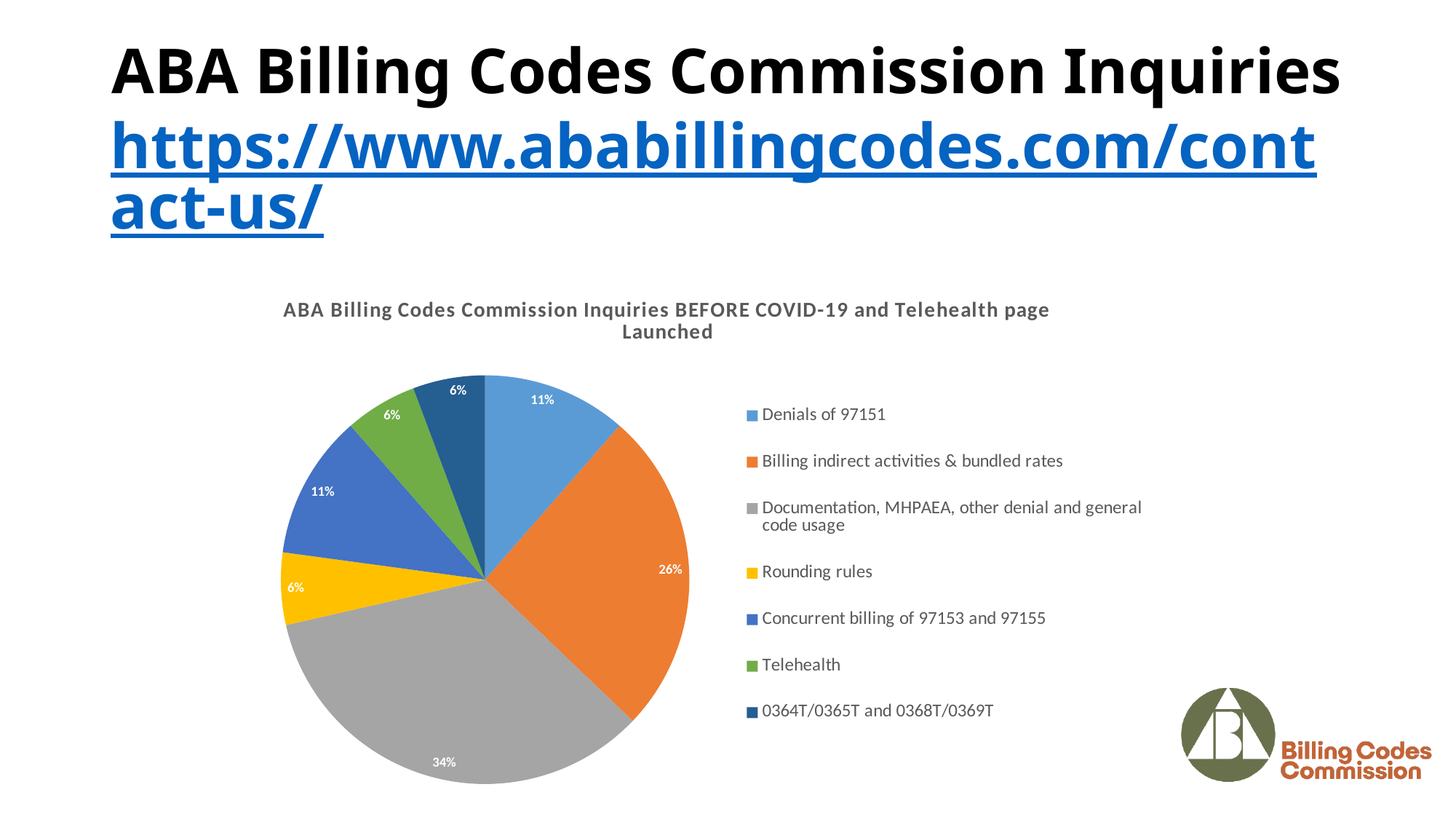
What share of inquiries is for Denials of 97151? 11% What share of inquiries is for Concurrent billing of 97153 and 97155? 11% What colour is the Telehealth slice? Green How many categories does the legend list? 7 Which is larger: the share for Denials of 97151 or the share for Billing indirect activities & bundled rates? Billing indirect activities & bundled rates Which category has the largest share of the pie? Documentation, MHPAEA, other denial and general code usage What share of inquiries is for Telehealth? 6% What is the title of the chart? ABA Billing Codes Commission Inquiries BEFORE COVID-19 and Telehealth page Launched What share of inquiries is for Billing indirect activities & bundled rates? 26% What kind of chart is shown on the slide? Pie chart What is the difference in percentage points between the Documentation, MHPAEA, other denial and general code usage slice and the Billing indirect activities & bundled rates slice? 8 percentage points What share of inquiries is for Rounding rules? 6%